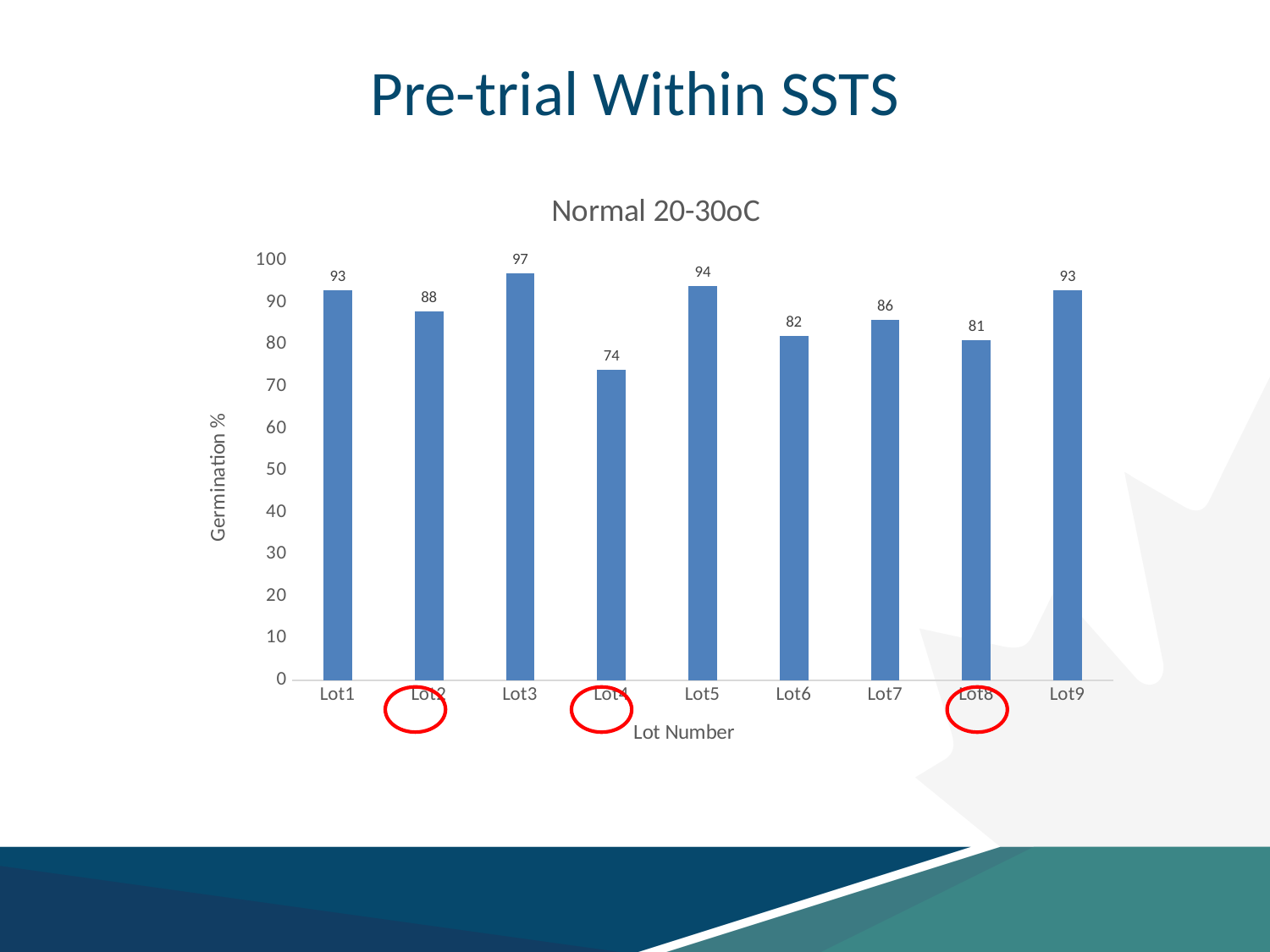
What is the title of the chart? Normal 20-30oC What is the germination % for Lot3? 97 Is the value for Lot2 greater or less than 80? greater How many lots are shown on the x axis? 9 Which lot has the lowest germination %? Lot4 Which has a higher germination %, Lot6 or Lot7? Lot7 What type of chart is shown? Bar chart Which lot has the highest germination %? Lot3 What is the germination % for Lot4? 74 What is the germination % for Lot8? 81 What is the difference in germination % between Lot3 and Lot4? 23 What is the label of the y axis? Germination %